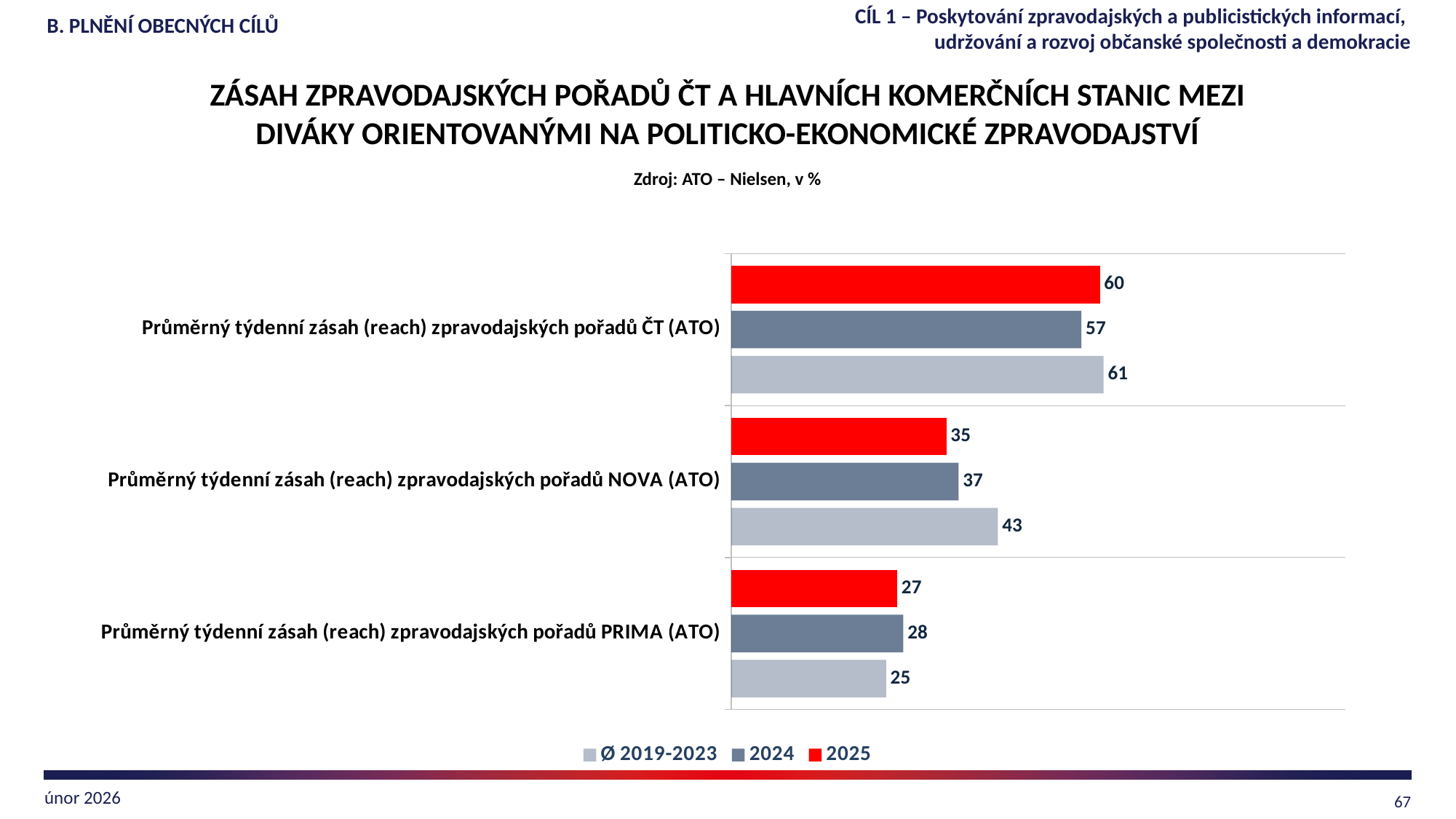
Which category has the lowest Ø 2019-2023 value? Průměrný týdenní zásah (reach) zpravodajských pořadů PRIMA (ATO) What is the Ø 2019-2023 value for Průměrný týdenní zásah (reach) zpravodajských pořadů PRIMA (ATO)? 25 Which category has the highest 2025 value? Průměrný týdenní zásah (reach) zpravodajských pořadů ČT (ATO) What is the 2025 value for Průměrný týdenní zásah (reach) zpravodajských pořadů ČT (ATO)? 60 Which colour represents the 2025 series in the legend? Red What is the 2024 value for Průměrný týdenní zásah (reach) zpravodajských pořadů NOVA (ATO)? 37 What kind of chart is shown on the slide? Bar chart How many categories are shown on the chart? 3 What is the difference between the 2025 values for ČT (ATO) and NOVA (ATO)? 25 How many series does the legend list? 3 What is the difference between the Ø 2019-2023 and 2025 values for Průměrný týdenní zásah (reach) zpravodajských pořadů NOVA (ATO)? 8 Which is larger for Průměrný týdenní zásah (reach) zpravodajských pořadů PRIMA (ATO): the 2024 value or the Ø 2019-2023 value? 2024